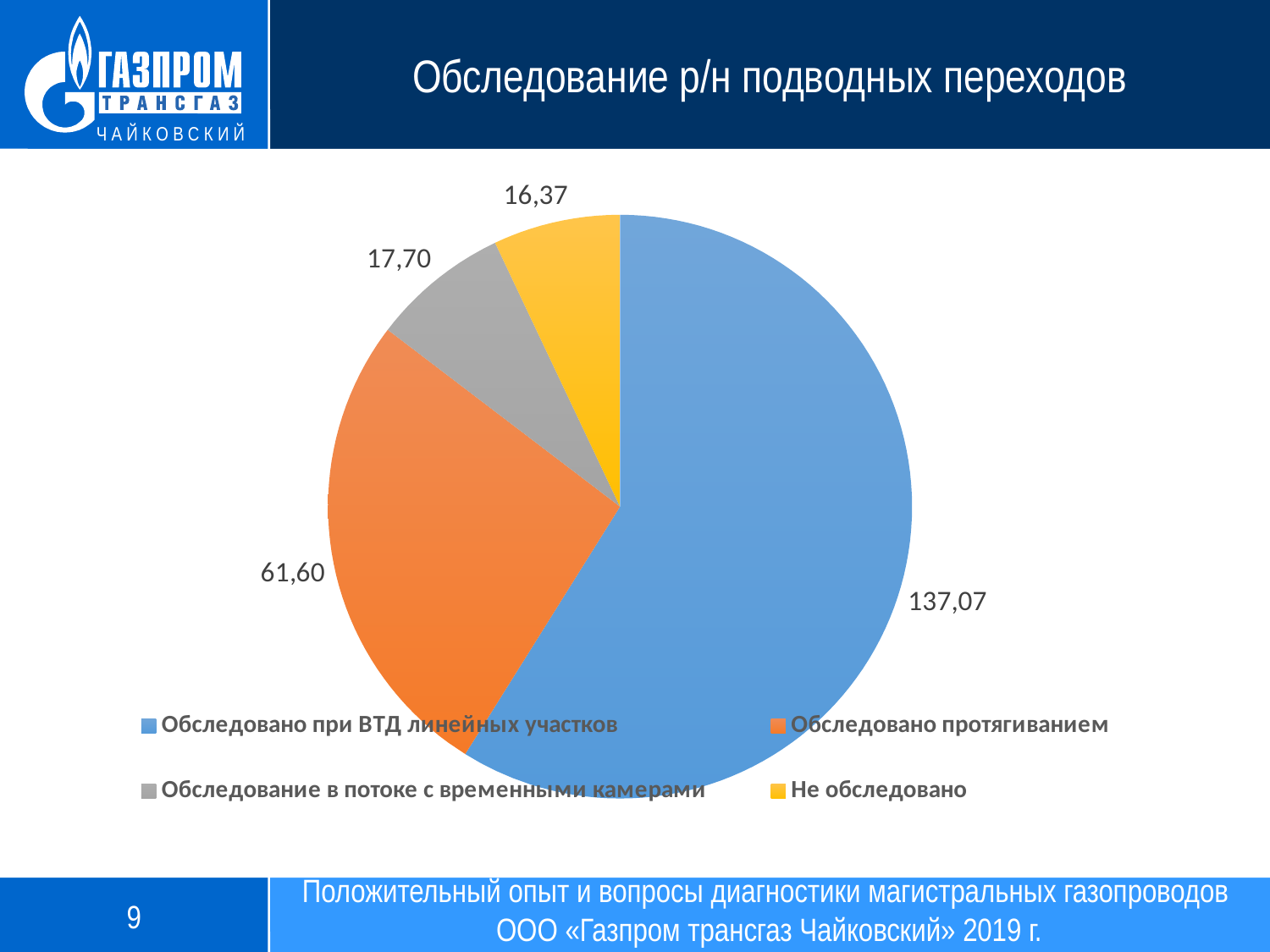
What is the value for "Обследовано при ВТД линейных участков"? 137,07 How many slices does the pie chart have? 4 What is the value for "Не обследовано"? 16,37 Which is larger: the value for "Обследовано протягиванием" or the value for "Обследование в потоке с временными камерами"? Обследовано протягиванием What type of chart is shown on the slide? Pie chart What is the title of the chart on the slide? Обследование р/н подводных переходов Which category has the smallest slice of the pie? Не обследовано What is the value for "Обследовано протягиванием"? 61,60 What is the value for "Обследование в потоке с временными камерами"? 17,70 What colour is the slice for "Не обследовано"? Yellow Which category has the largest slice of the pie? Обследовано при ВТД линейных участков What is the difference between the values for "Обследовано при ВТД линейных участков" and "Обследовано протягиванием"? 75,47